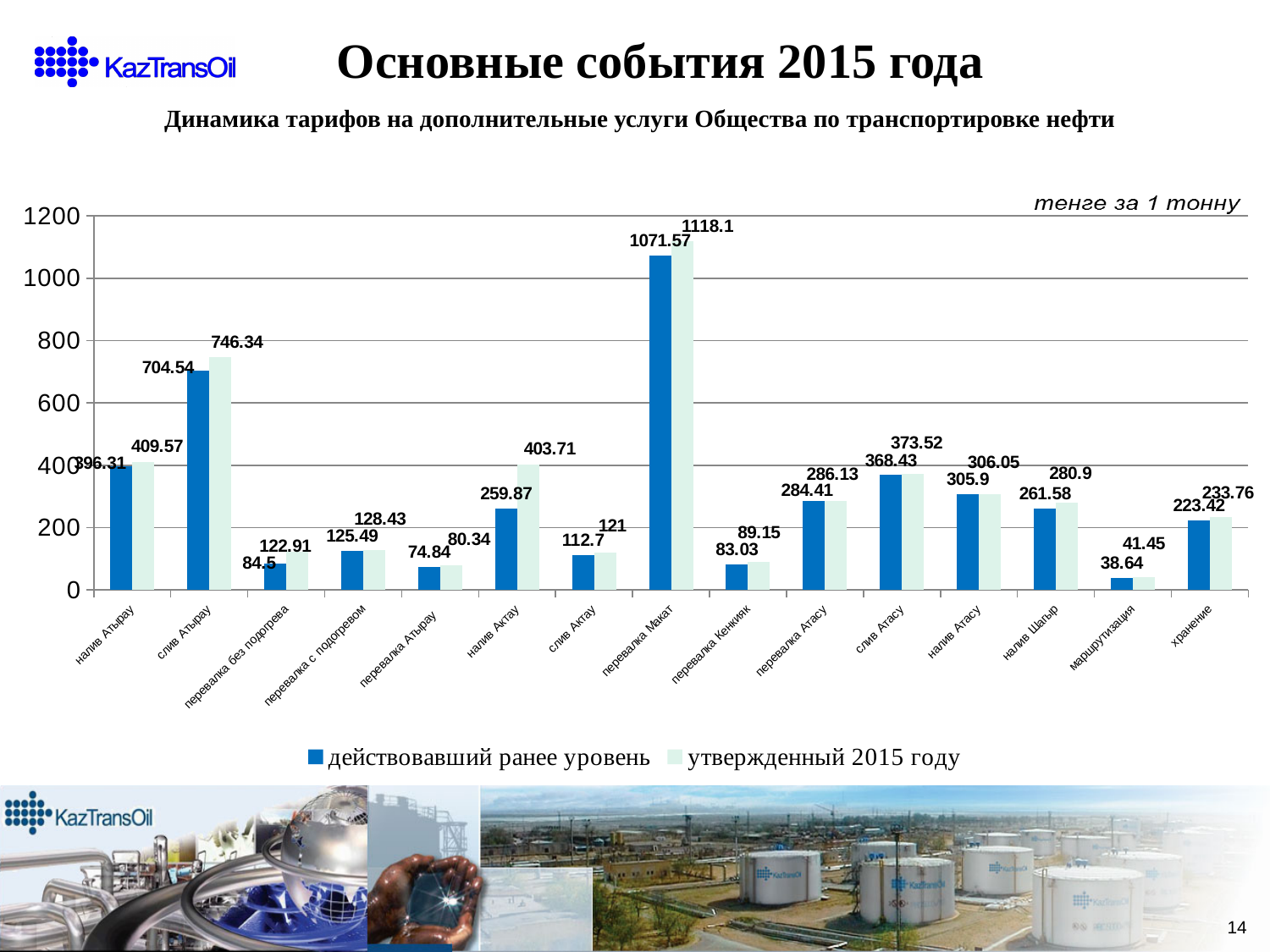
What is the value of the 'утвержденный 2015 году' series for налив Актау? 403.71 Is the 'утвержденный 2015 году' value for хранение greater or less than 200? greater What is the difference between the 'утвержденный 2015 году' and 'действовавший ранее уровень' values for налив Актау? 143.84 What is the value of the 'действовавший ранее уровень' series for перевалка Макат? 1071.57 What is the value of the 'действовавший ранее уровень' series for маршрутизация? 38.64 Which category has the lowest value in the 'действовавший ранее уровень' series? маршрутизация What kind of chart is shown on the slide? bar chart Which category has the highest value in the 'утвержденный 2015 году' series? перевалка Макат How many series does the legend list? 2 What is the value of the 'утвержденный 2015 году' series for слив Атырау? 746.34 Which is larger for перевалка без подогрева: the 'действовавший ранее уровень' value or the 'утвержденный 2015 году' value? утвержденный 2015 году How many categories are shown on the x axis? 15